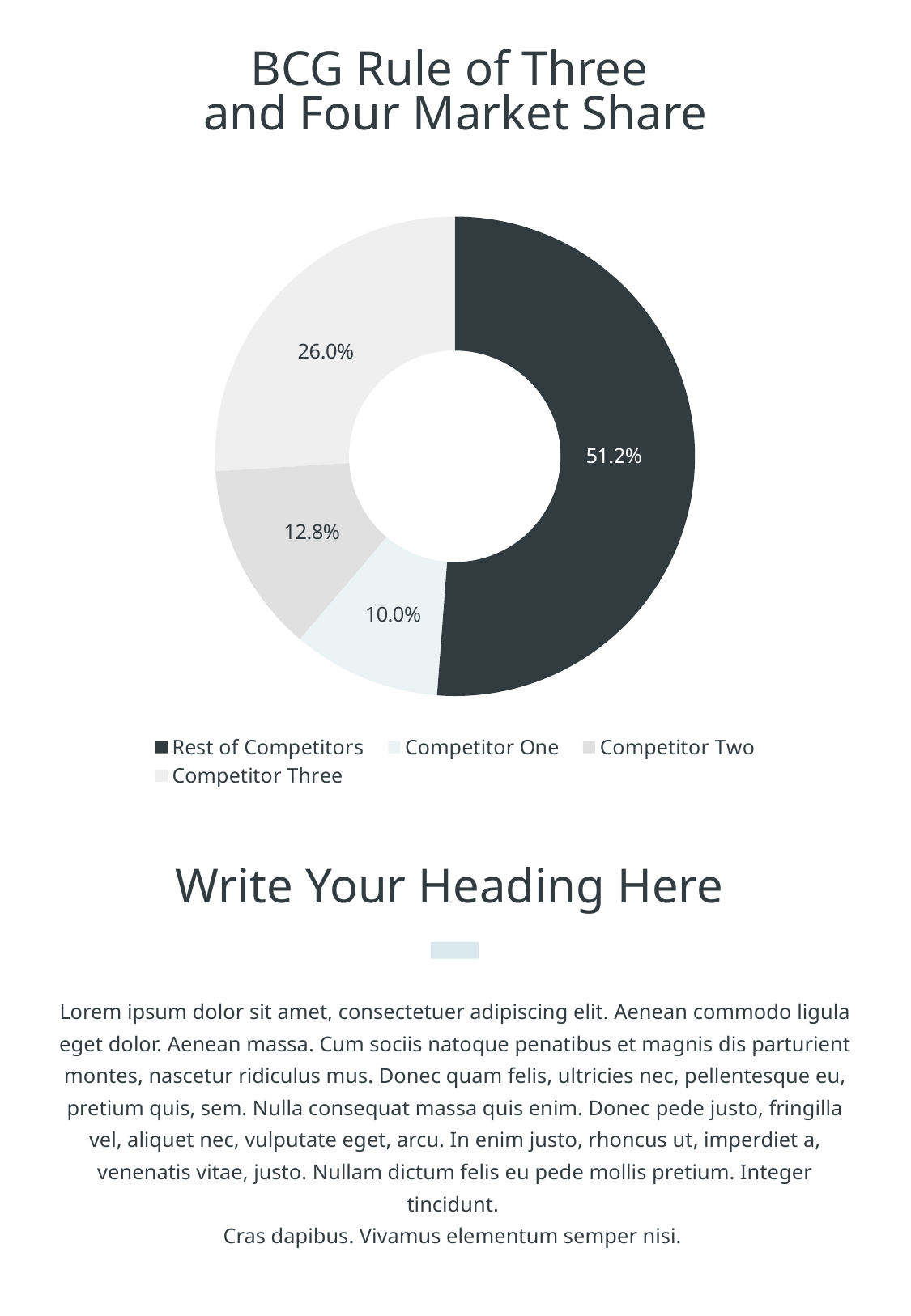
What kind of chart is shown on the slide? Doughnut chart What is the value shown for Competitor Three? 26.0% Which category has the largest slice? Rest of Competitors What is the value shown for Competitor One? 10.0% What share of the market does Rest of Competitors hold? 51.2% What is the title of the chart? BCG Rule of Three and Four Market Share How many slices does the chart have? 4 What is the value shown for Competitor Two? 12.8% Which category has the smallest slice? Competitor One Which is larger, the share of Competitor Two or Competitor One? Competitor Two What is the difference between the shares of Rest of Competitors and Competitor Three? 25.2% What is the difference between the shares of Competitor Three and Competitor Two? 13.2%